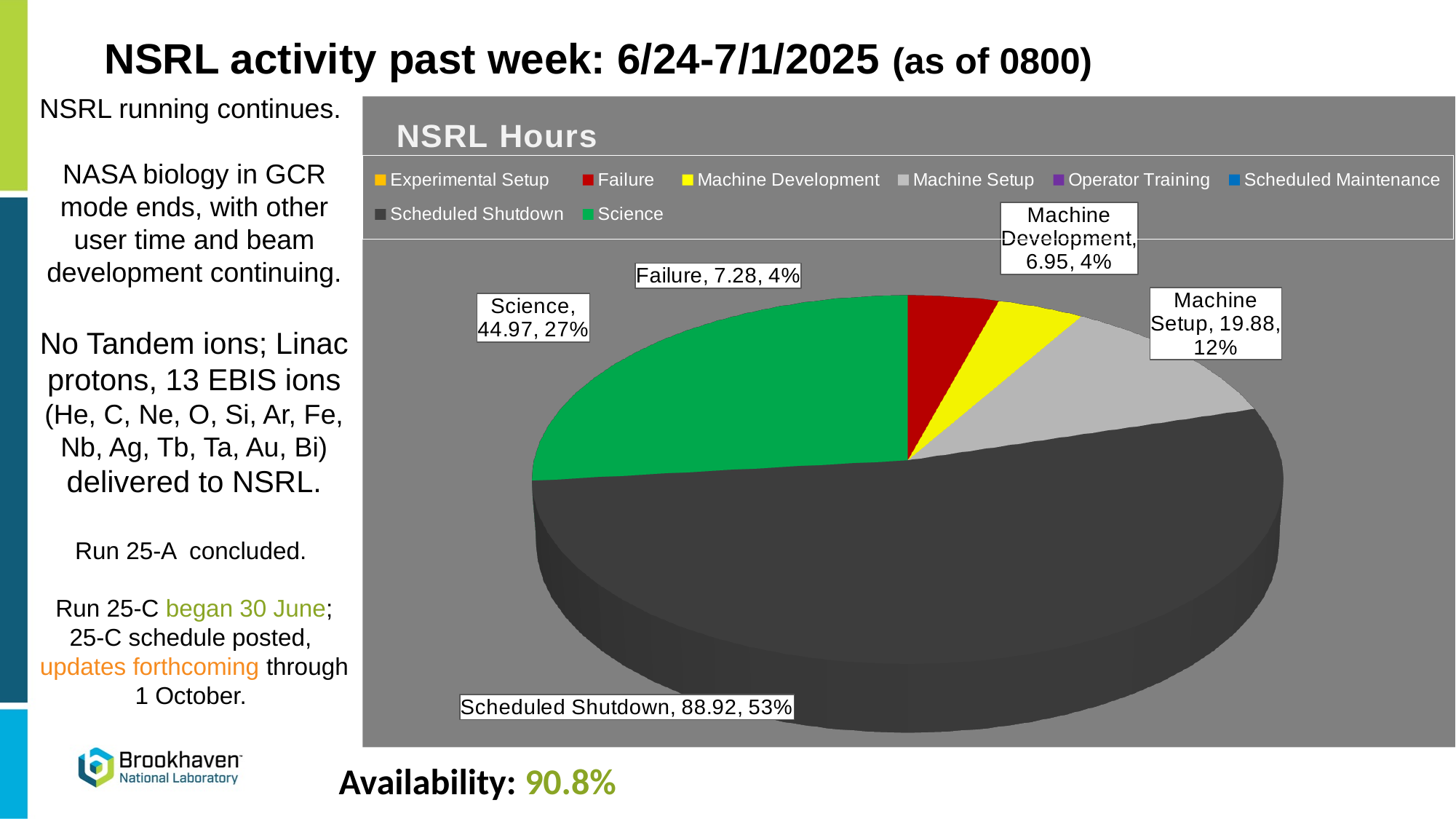
How many entries does the chart legend list? 8 What percentage share of the pie does Science have? 27% How many hours are shown for Failure? 7.28 How many hours are shown for Machine Setup? 19.88 What type of chart is shown on the slide? pie chart How many hours are shown for Science in the NSRL Hours chart? 44.97 Which labeled category has the smallest number of hours in the pie chart? Machine Development Which category has the largest slice of the NSRL Hours pie? Scheduled Shutdown What is the difference in hours between Science and Machine Setup? 25.09 What is the title of the chart? NSRL Hours What percentage share of the pie does Machine Setup have? 12% How many hours are shown for Scheduled Shutdown? 88.92